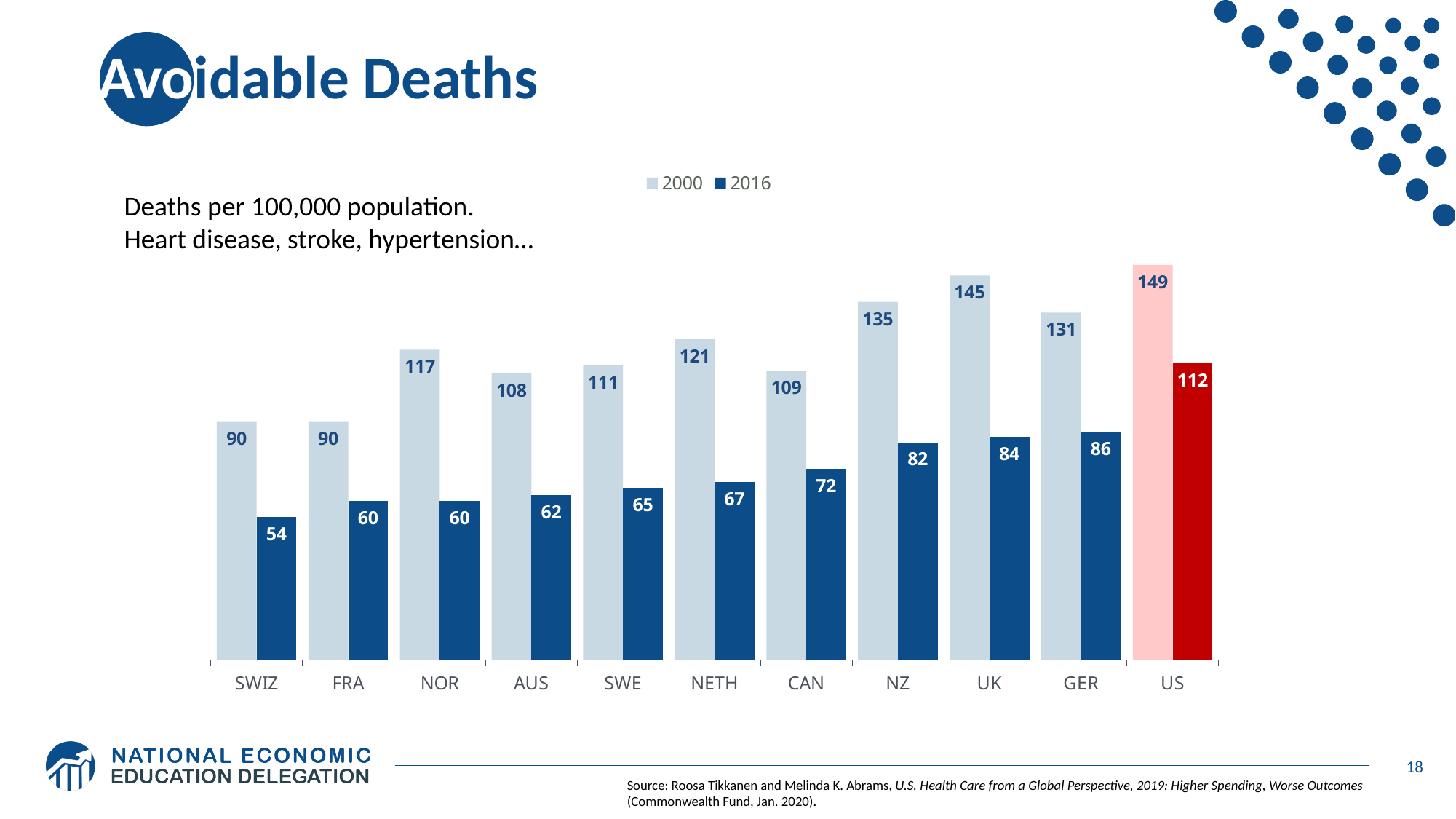
Which country has the lowest 2016 value? SWIZ Which is larger, the 2016 value for GER or the 2016 value for NZ? GER How many series does the legend list? 2 What are the two series listed in the legend? 2000 and 2016 What is the difference between the 2000 and 2016 values for the UK? 61 What is the 2016 value for the US? 112 What is the 2016 value for SWIZ? 54 What is the 2000 value for NOR? 117 What kind of chart is shown on the slide? Bar chart Which country has the highest 2000 value? US How many countries are shown on the x axis? 11 What is the difference between the 2000 values for the US and SWIZ? 59